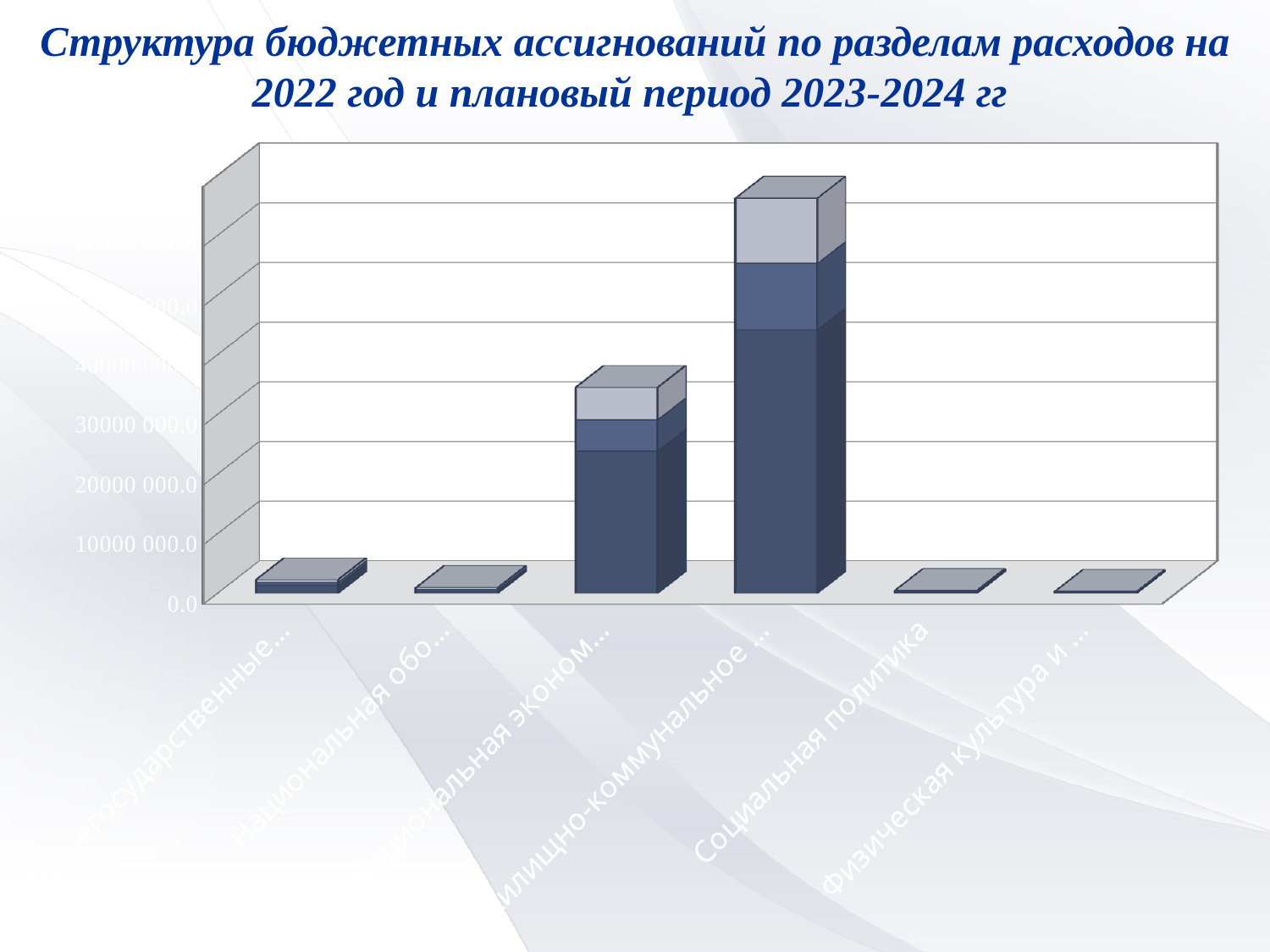
Which category has the tallest bar in the chart? Жилищно-коммунальное ... What kind of chart is shown on the slide? Stacked bar chart Is the total value for the 'Национальная эконом...' bar greater or less than 20000 000.0? greater What is the title of the slide above the chart? Структура бюджетных ассигнований по разделам расходов на 2022 год и плановый период 2023-2024 гг Is the value for 'Общегосударственные...' greater or less than 10000 000.0? less Is the total value for the 'Жилищно-коммунальное ...' bar greater or less than 40000 000.0? greater How many categories are plotted along the x axis of the chart? 6 Which bar is taller: 'Общегосударственные...' or 'Национальная эконом...'? Национальная эконом... How many stacked segments make up the 'Жилищно-коммунальное ...' bar? 3 Which bar is taller: 'Национальная эконом...' or 'Жилищно-коммунальное ...'? Жилищно-коммунальное ...